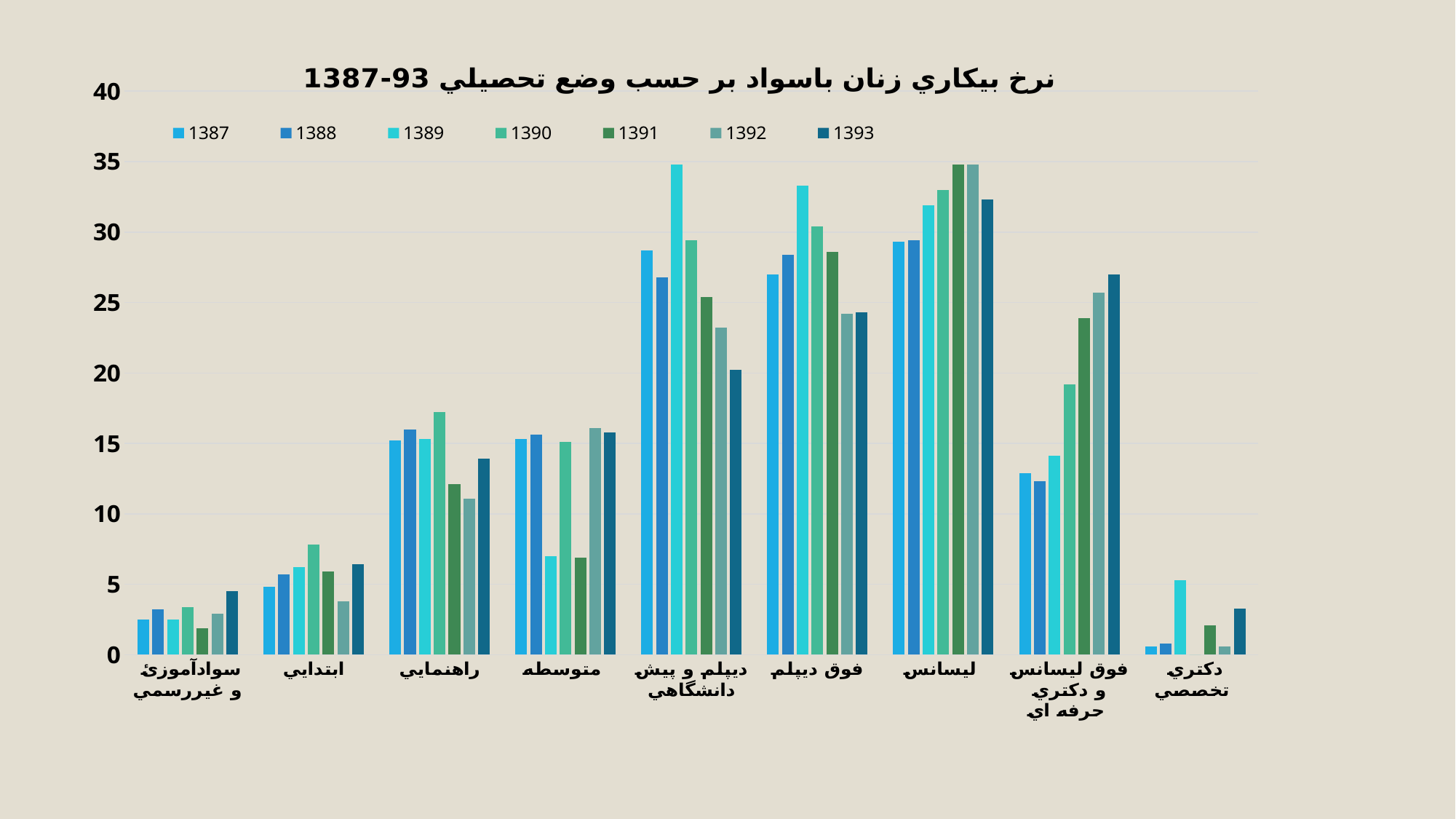
How many series does the legend list? 7 Is the value for 1393 in the فوق ليسانس و دكتري حرفه اي category greater or less than 25? greater How many education-level categories are shown on the x axis? 9 Do the values for فوق ليسانس و دكتري حرفه اي rise or fall from 1389 to 1393? rise In the ديپلم و پيش دانشگاهي category, which is larger: the value for 1389 or the value for 1393? 1389 What kind of chart is shown on the slide? bar chart Is the value for 1392 in the ابتدايي category greater or less than 5? less Which category has the lowest value for the 1387 series? دكتري تخصصي Is the value for 1391 in the متوسطه category greater or less than 10? less Which year is the first entry in the legend? 1387 Which category has the highest value for the 1393 series? ليسانس